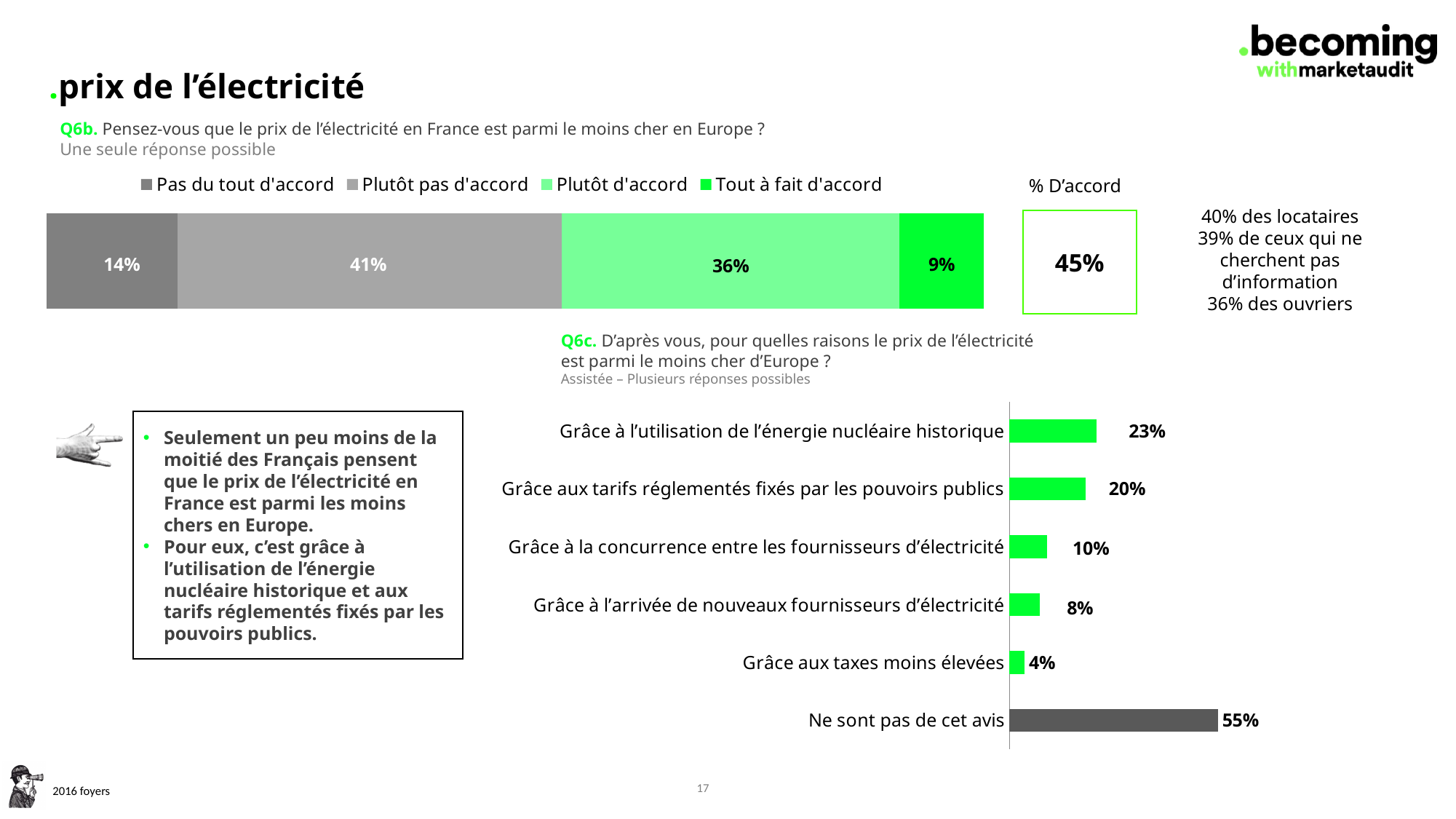
In the Q6b stacked bar chart at the top, how many series does the legend list? 4 In the Q6c bar chart at the bottom, which category has the lowest value? Grâce aux taxes moins élevées In the Q6c bar chart at the bottom, which category has the highest value? Ne sont pas de cet avis In the Q6b stacked bar chart at the top, what is the combined total of "Plutôt d'accord" and "Tout à fait d'accord"? 45% In the Q6c bar chart at the bottom, what is the value for "Grâce à l'utilisation de l'énergie nucléaire historique"? 23% In the Q6b stacked bar chart at the top, which response category has the largest share? Plutôt pas d'accord In the Q6c bar chart at the bottom, what is the value for "Grâce aux taxes moins élevées"? 4% In the Q6b stacked bar chart at the top, what percentage of respondents answered "Plutôt pas d'accord"? 41% In the Q6c bar chart at the bottom, how many categories are shown? 6 In the Q6b stacked bar chart at the top, what percentage answered "Tout à fait d'accord"? 9% In the Q6b stacked bar chart at the top, what is the difference between "Plutôt pas d'accord" and "Pas du tout d'accord"? 27% In the Q6c bar chart at the bottom, what is the difference between "Grâce aux tarifs réglementés fixés par les pouvoirs publics" and "Grâce à la concurrence entre les fournisseurs d'électricité"? 10%